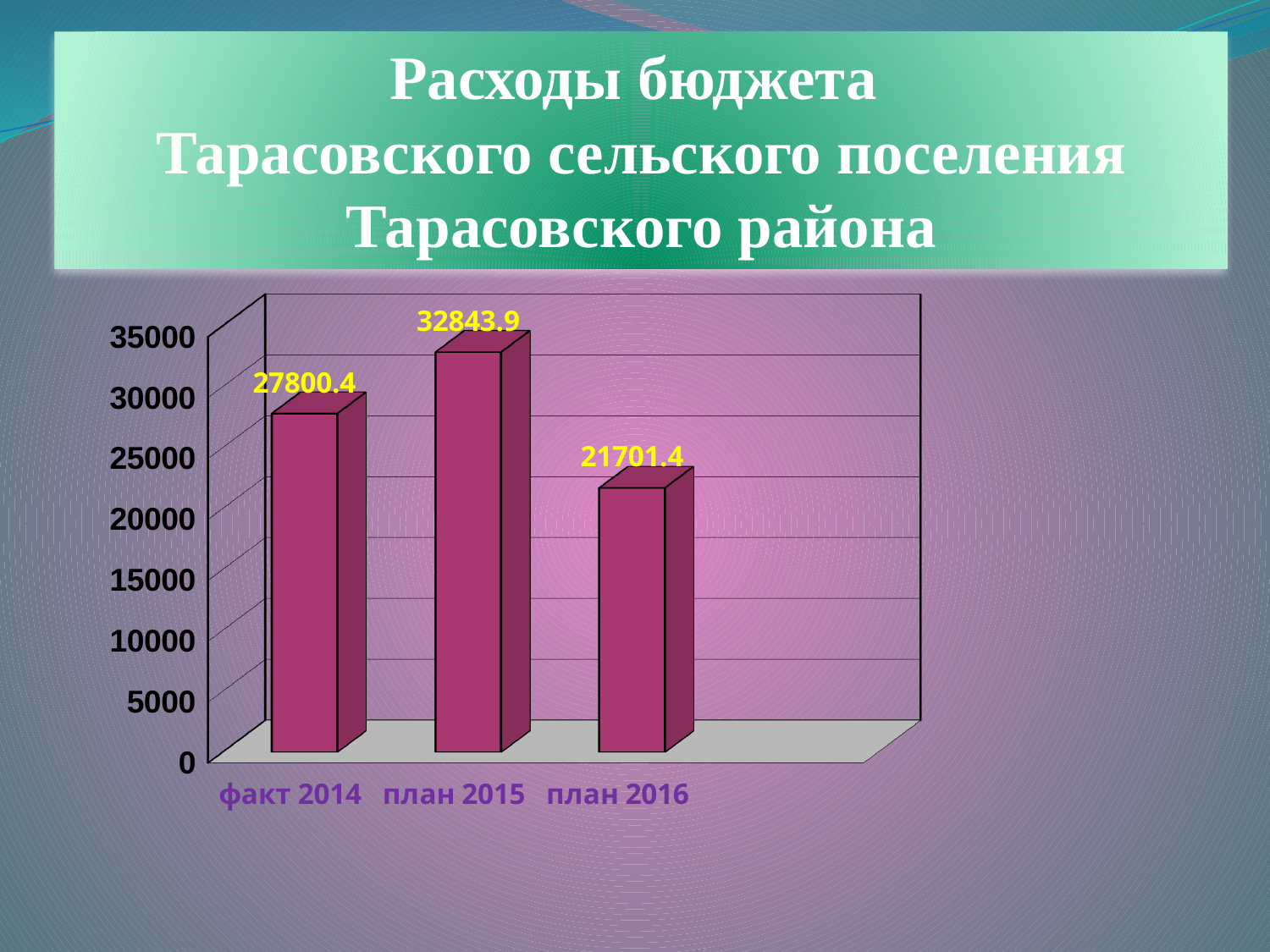
What is the title of the slide above the chart? Расходы бюджета Тарасовского сельского поселения Тарасовского района What is the difference between the values for план 2015 and факт 2014? 5043.5 What is the value for план 2015? 32843.9 What is the value for факт 2014? 27800.4 Which is larger, the value for факт 2014 or the value for план 2016? факт 2014 Is the value for план 2016 greater or less than 25000? less What kind of chart is shown on the slide? bar chart How many categories are shown on the x axis? 3 What is the difference between the values for факт 2014 and план 2016? 6099 Which category has the highest value? план 2015 Which category has the lowest value? план 2016 What is the value for план 2016? 21701.4